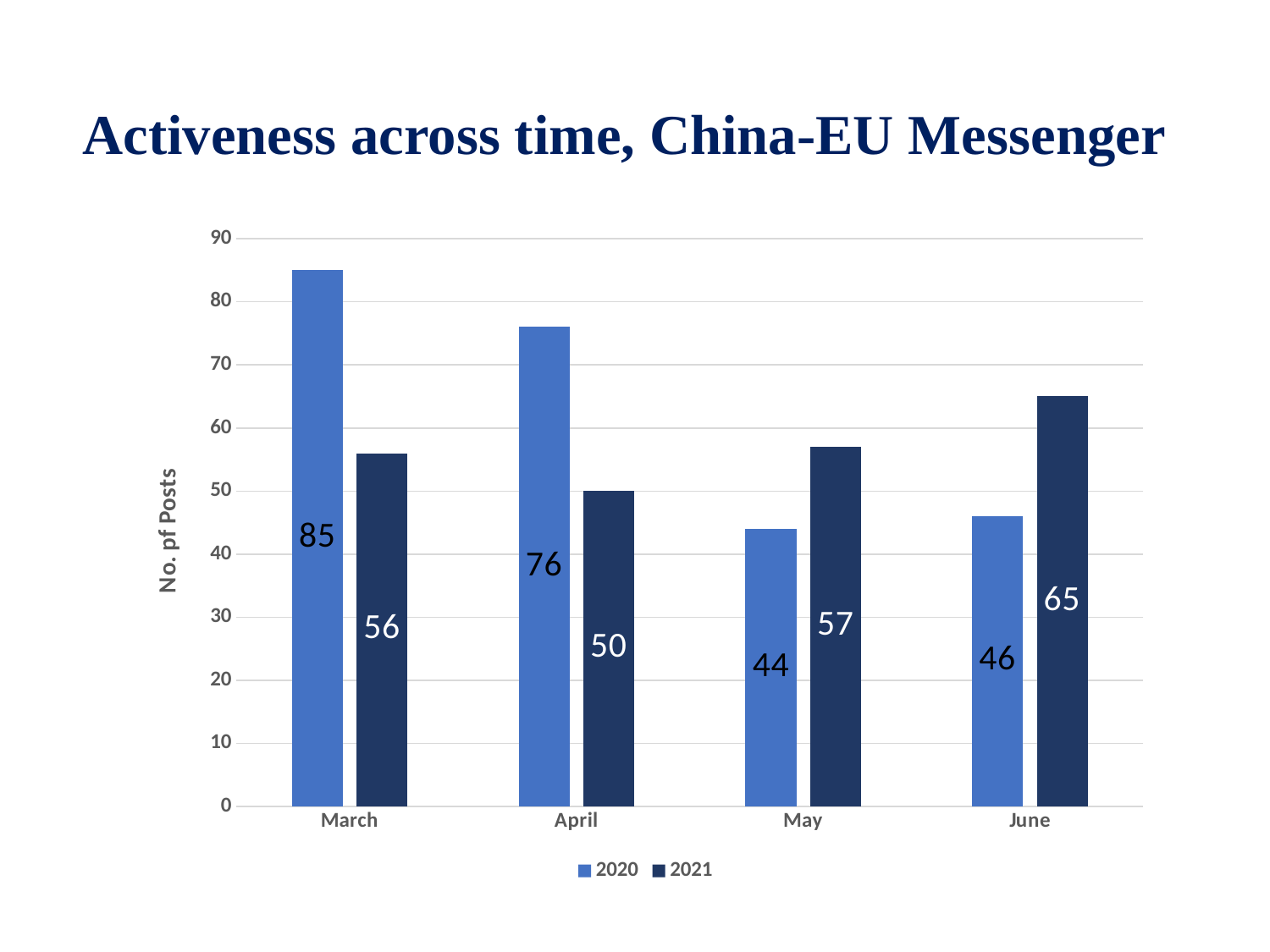
What is the number of posts for March in 2020? 85 Which month has the lowest number of posts in the 2021 series? April What kind of chart is shown on the slide? bar chart What is the number of posts for June in 2021? 65 What is the difference between the 2020 and 2021 values for March? 29 Which month has the highest number of posts in the 2020 series? March How many series does the legend list? 2 Do the 2020 values rise or fall from March to May? fall Is the 2020 value for April greater or less than 70? greater How many months are shown on the x axis? 4 Which is larger for May: the 2020 value or the 2021 value? 2021 What is the number of posts for May in 2020? 44